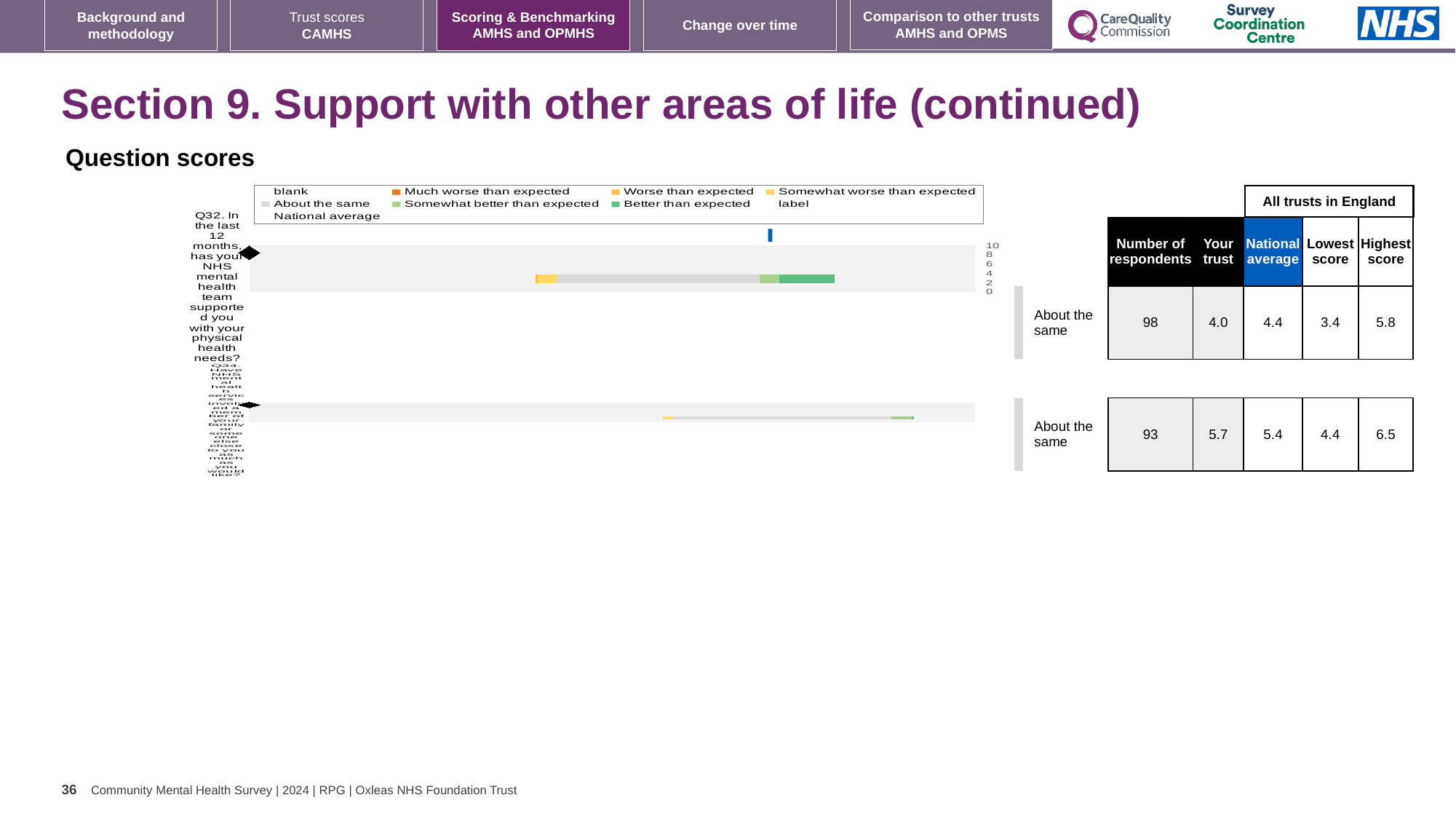
What colour represents 'Much worse than expected' in the chart legend? Orange What is the difference between the highest and lowest trust scores for Q34? 2.1 For Q32, which is larger: the trust's score or the national average? National average What does the blue marker in the chart legend represent? National average What kind of chart is used to show the question scores on this slide? bar chart Which question had more respondents, Q32 or Q34? Q32 What is the 'Your trust' score for Q34 (involving family or someone close)? 5.7 What is the highest score among all trusts in England for Q34? 6.5 How many questions (rows) are plotted in the question scores chart? 2 How many respondents answered Q34? 93 What is the national average score for Q32? 4.4 What is the 'Your trust' score for Q32 (support with physical health needs)? 4.0